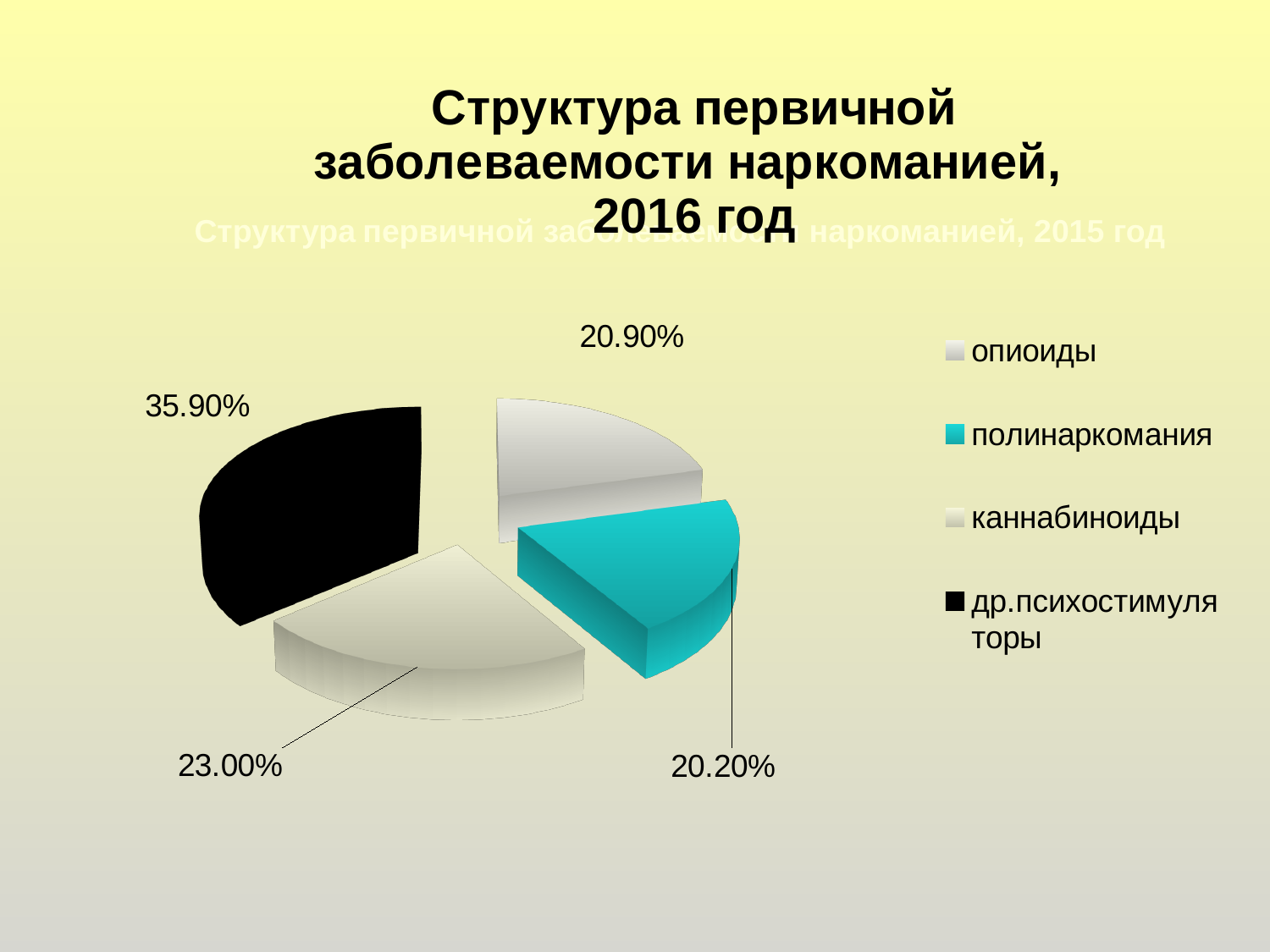
How many entries does the legend list? 4 What is the value shown for каннабиноиды? 23.00% What is the difference between the shares of др.психостимуляторы and каннабиноиды? 12.90% How many slices does the pie chart have? 4 Which category has the largest slice of the pie? др.психостимуляторы Which category has the smallest slice of the pie? полинаркомания What kind of chart is shown on the slide? pie chart Which is larger, the share for каннабиноиды or the share for опиоиды? каннабиноиды What is the value shown for опиоиды? 20.90% What is the value shown for полинаркомания? 20.20% What share of the pie does the slice for др.психостимуляторы represent? 35.90% What colour is the slice for полинаркомания? teal